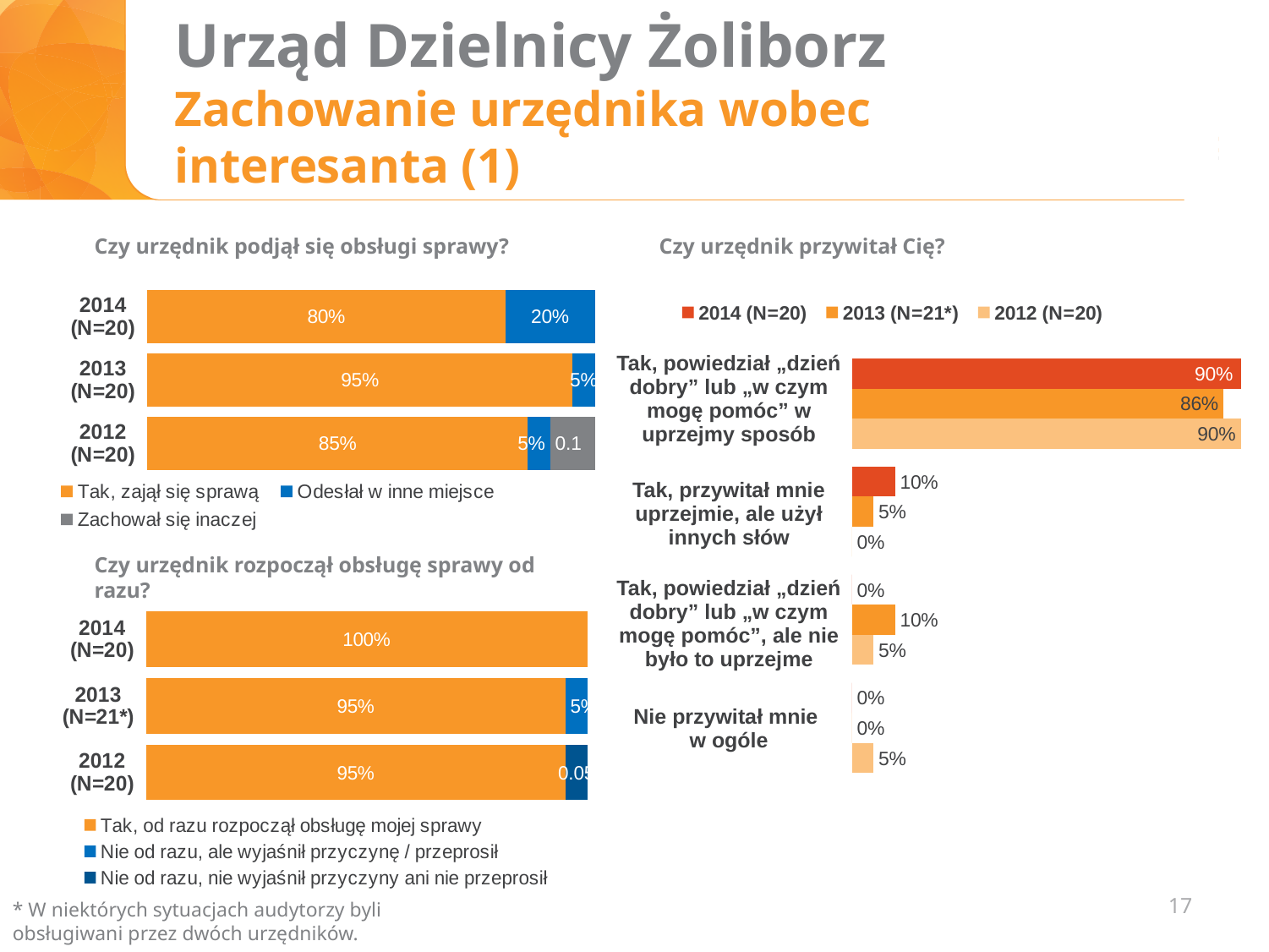
In the chart "Czy urzędnik podjął się obsługi sprawy?", what is the value for "Odesłał w inne miejsce" in 2014 (N=20)? 20% In the chart "Czy urzędnik rozpoczął obsługę sprawy od razu?", what is the value for "Tak, od razu rozpoczął obsługę mojej sprawy" in 2014 (N=20)? 100% In the chart "Czy urzędnik podjął się obsługi sprawy?", what percentage of cases in 2014 (N=20) were "Tak, zajął się sprawą"? 80% In the chart "Czy urzędnik przywitał Cię?", what is the value for 2013 (N=21*) in the category "Tak, powiedział „dzień dobry” lub „w czym mogę pomóc” w uprzejmy sposób"? 86% In the chart "Czy urzędnik przywitał Cię?", what is the value for 2014 (N=20) in the category "Tak, przywitał mnie uprzejmie, ale użył innych słów"? 10% In the chart "Czy urzędnik przywitał Cię?", which is larger for the category "Nie przywitał mnie w ogóle": the value for 2012 (N=20) or for 2014 (N=20)? 2012 (N=20) In the chart "Czy urzędnik rozpoczął obsługę sprawy od razu?", what is the value for "Nie od razu, ale wyjaśnił przyczynę / przeprosił" in 2013 (N=21*)? 5% In the chart "Czy urzędnik przywitał Cię?", how many categories are shown on the axis? 4 In the chart "Czy urzędnik podjął się obsługi sprawy?", what is the difference between the "Tak, zajął się sprawą" values for 2013 (N=20) and 2014 (N=20)? 15% What type of chart is "Czy urzędnik rozpoczął obsługę sprawy od razu?"? Stacked bar chart In the chart "Czy urzędnik podjął się obsługi sprawy?", which year has the highest share of "Tak, zajął się sprawą"? 2013 (N=20) In the chart "Czy urzędnik podjął się obsługi sprawy?", how many series does the legend list? 3